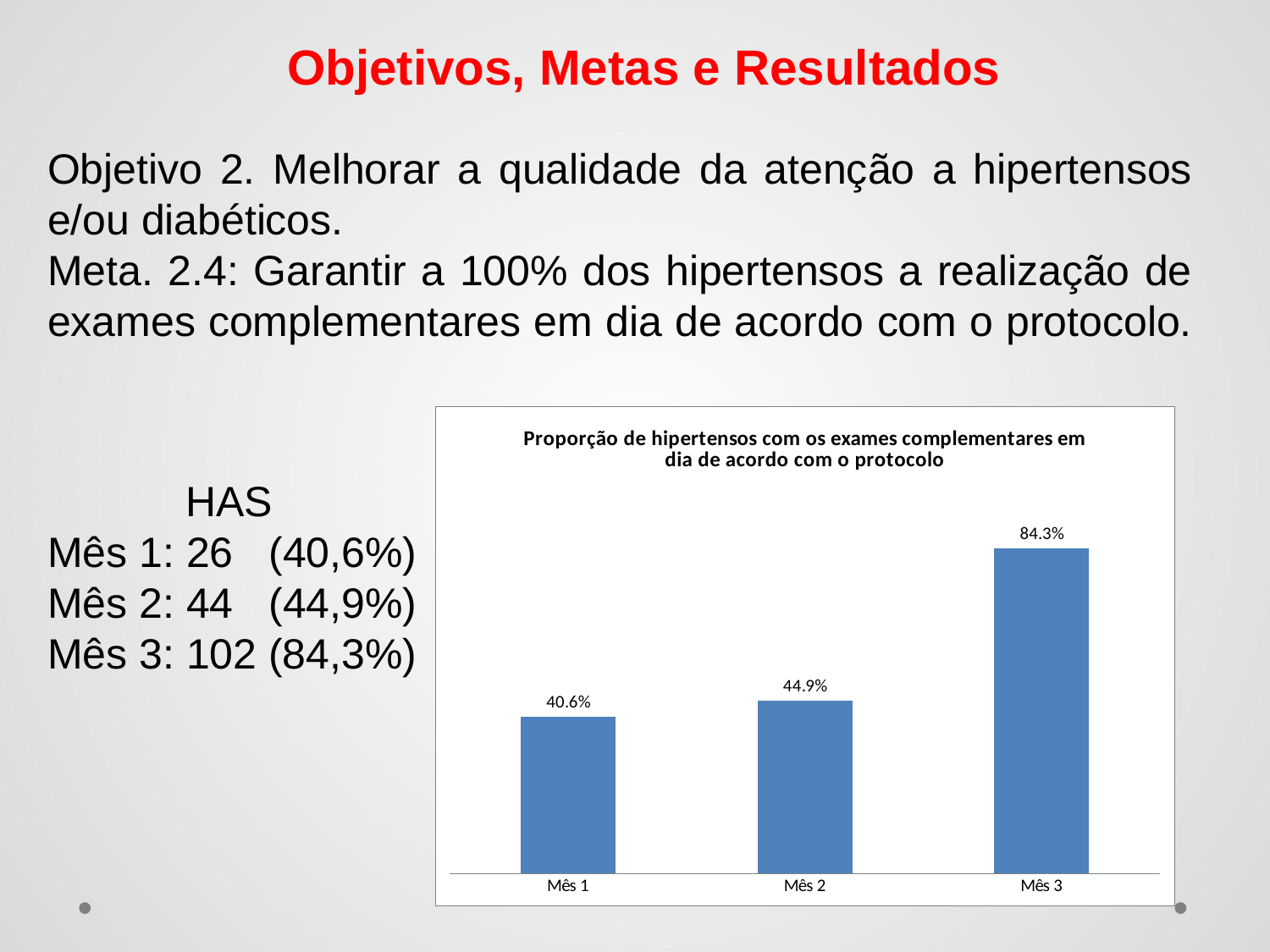
Do the values rise or fall from Mês 1 to Mês 3? Rise Which is larger, the value for Mês 1 or the value for Mês 3? Mês 3 What is the value for Mês 2? 44.9% What is the difference between the values for Mês 2 and Mês 1? 4.3% Which month has the highest value? Mês 3 What is the difference between the values for Mês 3 and Mês 2? 39.4% What is the value for Mês 3? 84.3% What is the title of the chart? Proporção de hipertensos com os exames complementares em dia de acordo com o protocolo Which month has the lowest value? Mês 1 What is the value for Mês 1? 40.6% What kind of chart is shown? Bar chart How many months are shown on the x axis? 3